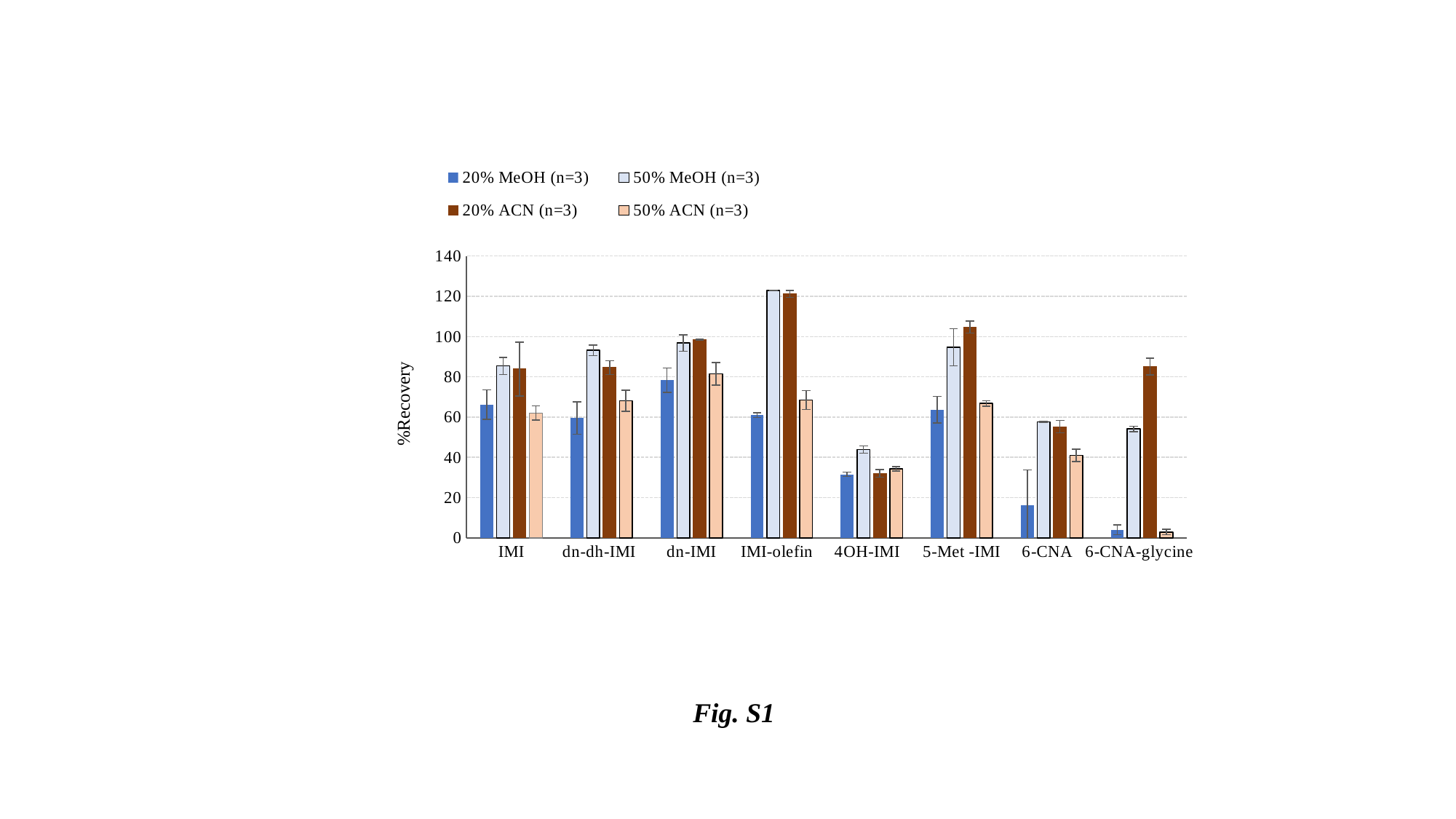
What is the label of the y axis? %Recovery How many series does the legend list? 4 Is the value for 20% MeOH (n=3) at 4OH-IMI greater or less than 40? less What kind of chart is shown on the slide? bar chart For IMI-olefin, which is larger: the 20% MeOH (n=3) value or the 50% MeOH (n=3) value? 50% MeOH (n=3) How many categories are shown on the x axis? 8 Which category has the highest 50% MeOH (n=3) value? IMI-olefin Is the value for 50% MeOH (n=3) at dn-dh-IMI greater or less than 80? greater For 6-CNA-glycine, which is larger: the 20% ACN (n=3) value or the 50% ACN (n=3) value? 20% ACN (n=3) Is the value for 50% MeOH (n=3) at IMI-olefin greater or less than 100? greater Which category has the lowest 50% ACN (n=3) value? 6-CNA-glycine